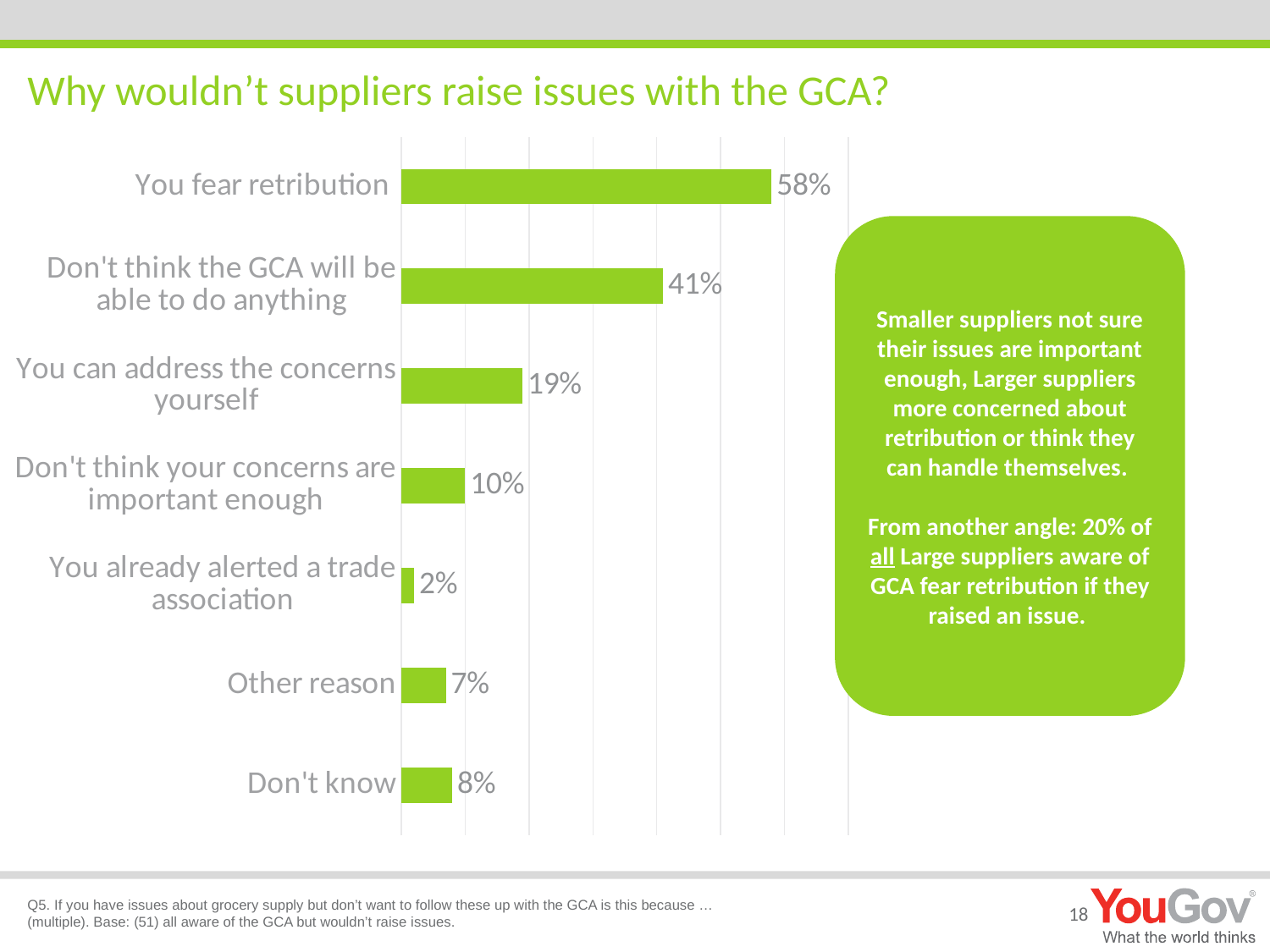
What type of chart is shown on the slide? Bar chart What percentage say they can address the concerns themselves? 19% What percentage of suppliers say they fear retribution? 58% What is the value for 'You already alerted a trade association'? 2% What is the value for 'Don't think the GCA will be able to do anything'? 41% What is the difference between 'You fear retribution' and 'Don't think the GCA will be able to do anything'? 17% What is the difference between 'Don't think your concerns are important enough' and 'Other reason'? 3% What is the title of the slide containing the chart? Why wouldn't suppliers raise issues with the GCA? Which reason has the highest percentage? You fear retribution How many reasons are shown in the chart? 7 Which is larger: 'Other reason' or 'Don't know'? Don't know Which reason has the lowest percentage? You already alerted a trade association